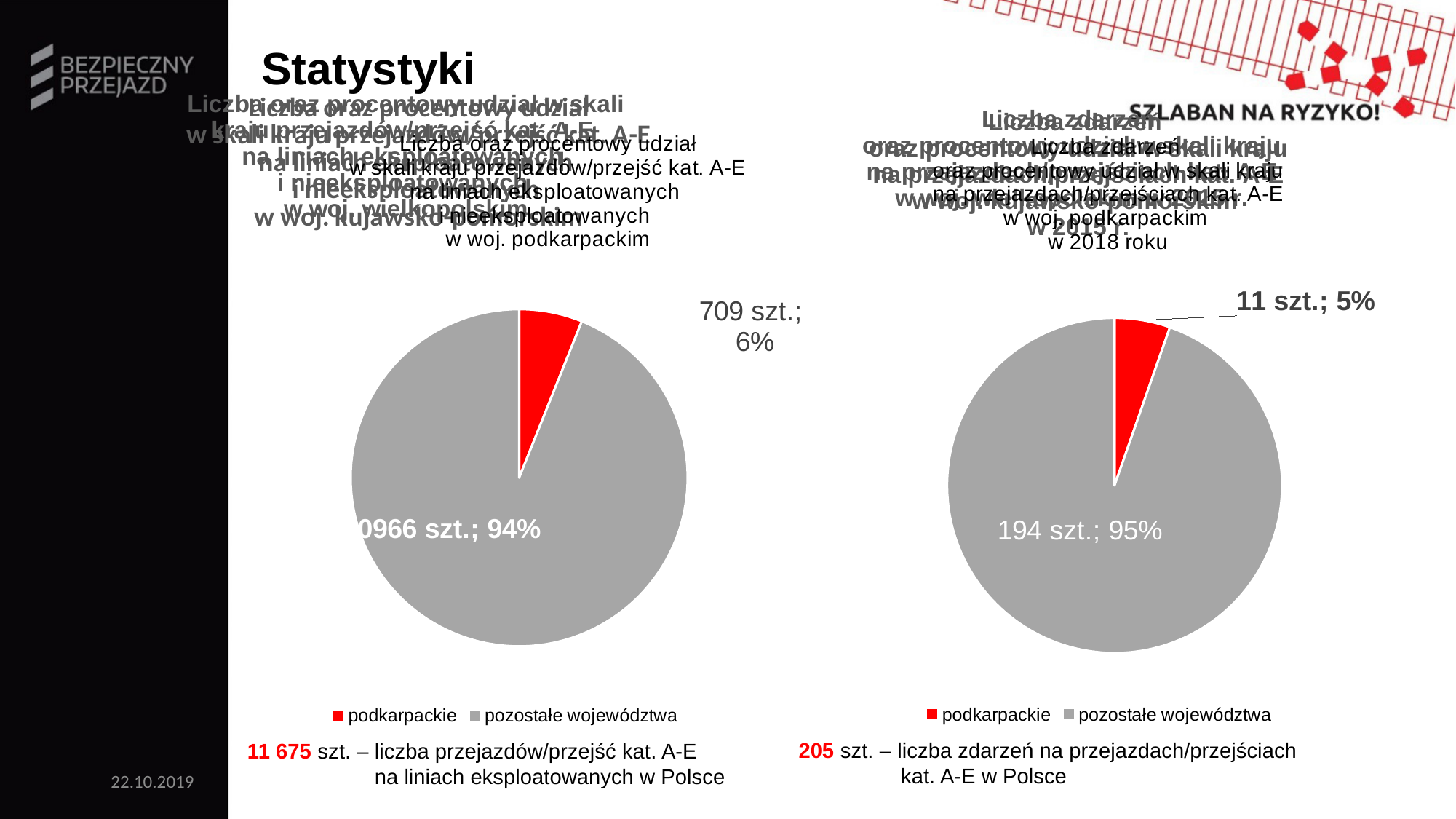
What kind of chart is the left chart on the slide? pie chart In the left pie chart, how many szt. are shown for podkarpackie? 709 szt. In the right pie chart, what is the total of the two slices in szt.? 205 szt. In the right pie chart, how many szt. are shown for podkarpackie? 11 szt. How many entries does the legend of the left pie chart list? 2 In the right pie chart, what colour is the podkarpackie slice? red In the right pie chart, what percentage share does podkarpackie have? 5% In the left pie chart, what percentage share does podkarpackie have? 6% In the left pie chart, which slice is larger: podkarpackie or pozostałe województwa? pozostałe województwa In the right pie chart, how many szt. are shown for pozostałe województwa? 194 szt. In the right pie chart, what is the difference in szt. between pozostałe województwa and podkarpackie? 183 szt. In the left pie chart, what percentage share do pozostałe województwa have? 94%